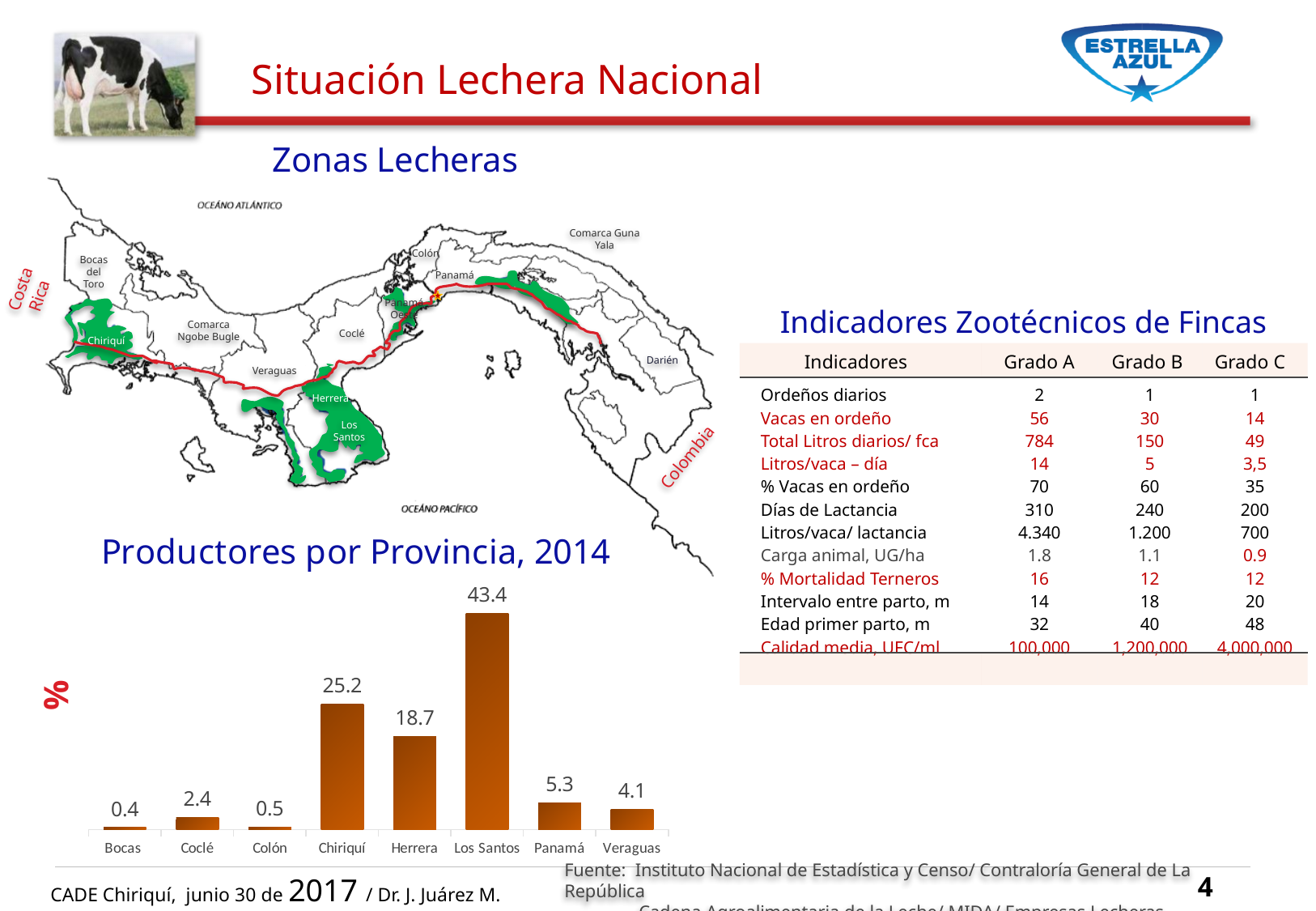
In the 'Productores por Provincia, 2014' chart, what is the value for Chiriquí? 25.2 In the 'Productores por Provincia, 2014' chart, what is the difference between the values for Panamá and Veraguas? 1.2 What is the label on the vertical axis of the 'Productores por Provincia, 2014' chart? % In the 'Productores por Provincia, 2014' chart, which is larger, the value for Coclé or the value for Colón? Coclé In the 'Productores por Provincia, 2014' chart, what is the value for Herrera? 18.7 In the 'Productores por Provincia, 2014' chart, which province has the lowest value? Bocas In the 'Productores por Provincia, 2014' chart, what is the value for Veraguas? 4.1 How many provinces are shown in the 'Productores por Provincia, 2014' chart? 8 What kind of chart is 'Productores por Provincia, 2014'? Bar chart In the 'Productores por Provincia, 2014' chart, what is the value for Los Santos? 43.4 In the 'Productores por Provincia, 2014' chart, what is the difference between the values for Los Santos and Chiriquí? 18.2 In the 'Productores por Provincia, 2014' chart, which province has the highest value? Los Santos